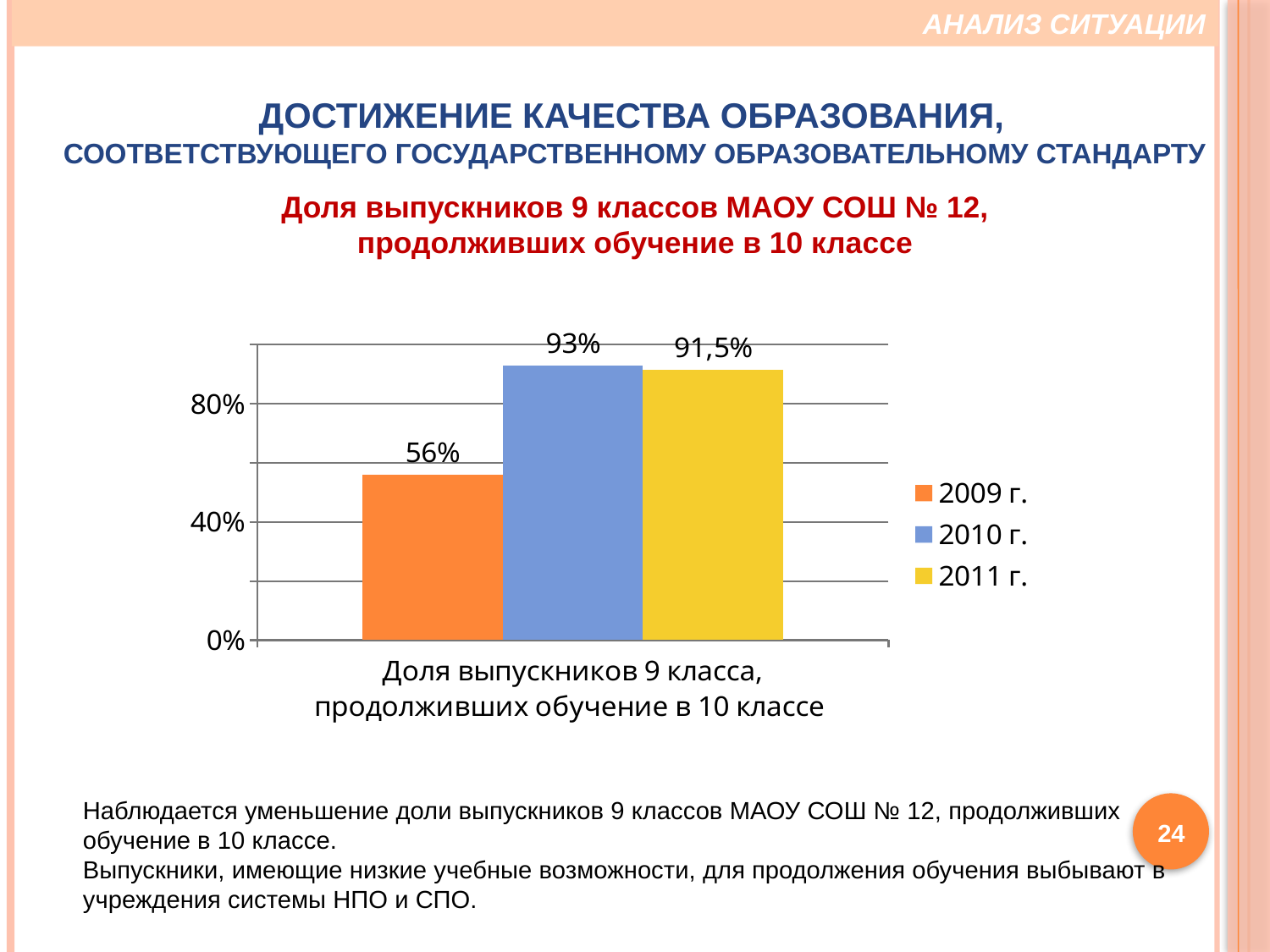
What is the value for 2009 г. in the chart? 56% Is the value for 2009 г. greater or less than 40%? greater Which is larger, the value for 2009 г. or the value for 2011 г.? 2011 г. What is the difference between the values for 2010 г. and 2011 г.? 1,5% What is the value for 2010 г. in the chart? 93% What is the value for 2011 г. in the chart? 91,5% How many series does the legend list? 3 Which year has the lowest value in the chart? 2009 г. What is the difference between the values for 2010 г. and 2009 г.? 37% What kind of chart is shown on the slide? bar chart What colour is the bar for 2011 г.? yellow Which year has the highest value in the chart? 2010 г.